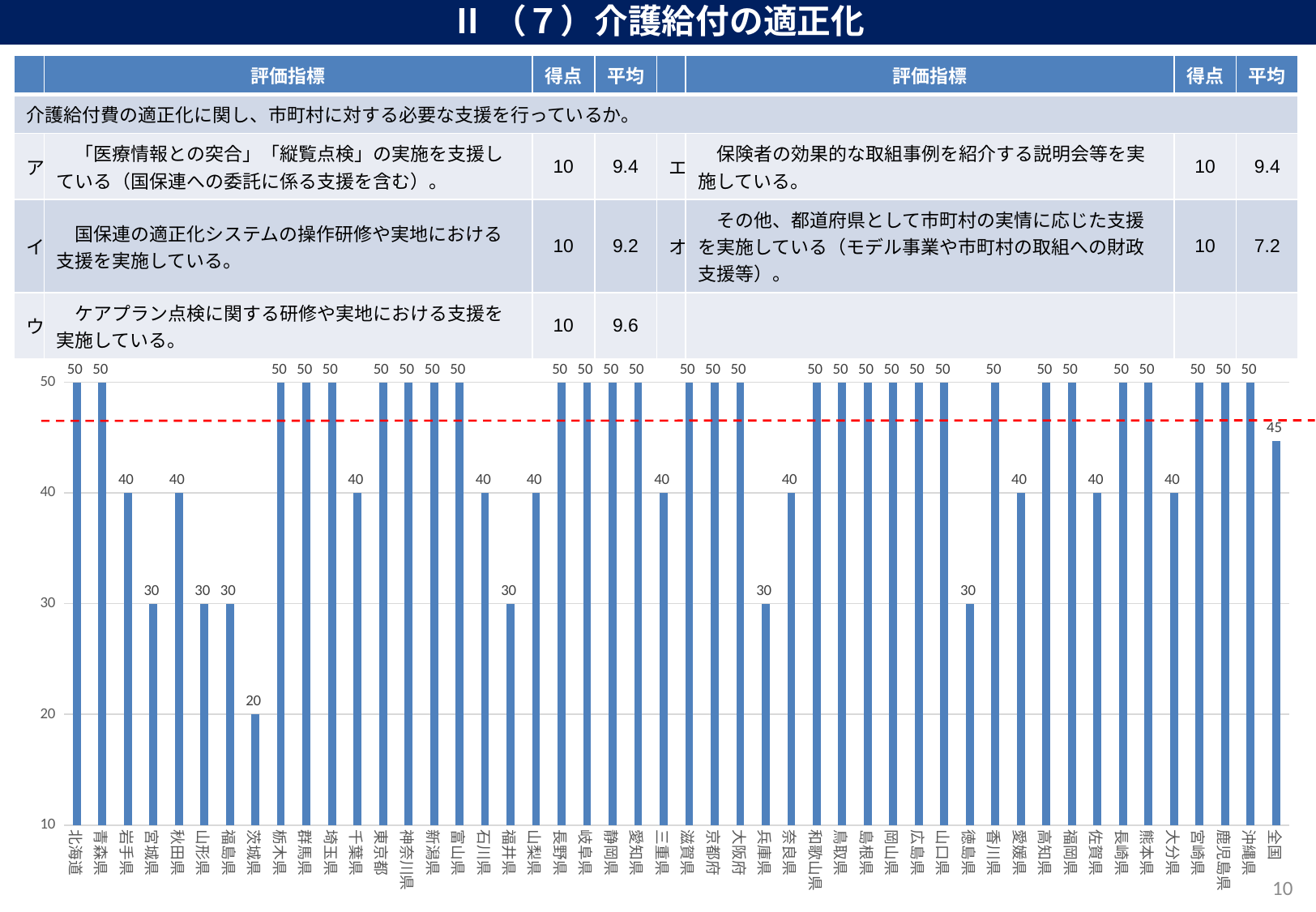
Which category has the lowest value in the bar chart? 茨城県 What is the difference between the values for 北海道 and 茨城県? 30 Which has the larger value, 岩手県 or 宮城県? 岩手県 What kind of chart is shown on the slide? bar chart Is the value for 徳島県 greater or less than 40? less What is the value for 兵庫県 in the bar chart? 30 What is the value for 全国 in the bar chart? 45 What is the value for 福井県 in the bar chart? 30 What is the value for 茨城県 in the bar chart? 20 What colour is the dashed horizontal line drawn across the chart? red How many bars are plotted in the chart? 48 What is the difference between the values for 全国 and 茨城県? 25